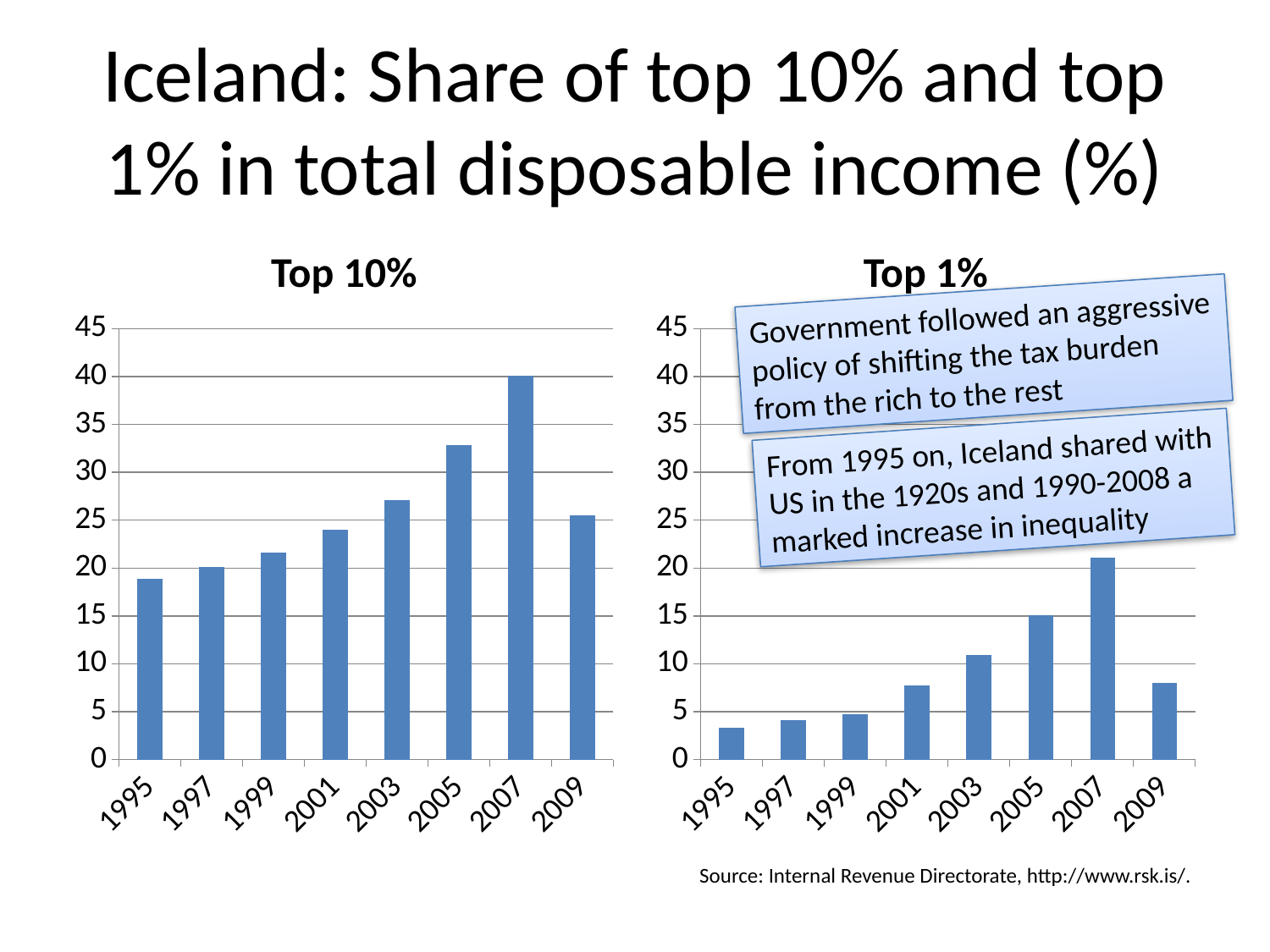
In the 'Top 10%' chart, do the values rise or fall from 1995 to 2007? rise How many years are shown on the x axis of the 'Top 10%' chart? 8 In the 'Top 1%' chart, which year has the lowest value? 1995 In the 'Top 10%' chart, which year has the lowest value? 1995 In the 'Top 10%' chart, is the value for 2005 greater or less than 30? greater In the 'Top 1%' chart, which is larger, the value for 2003 or the value for 2009? 2003 In the 'Top 1%' chart, which year has the highest value? 2007 In the 'Top 1%' chart, is the value for 2001 greater or less than 10? less In the 'Top 10%' chart, which year has the highest value? 2007 What kind of chart is the 'Top 10%' chart? bar chart In the 'Top 1%' chart, is the value for 2007 greater or less than 20? greater